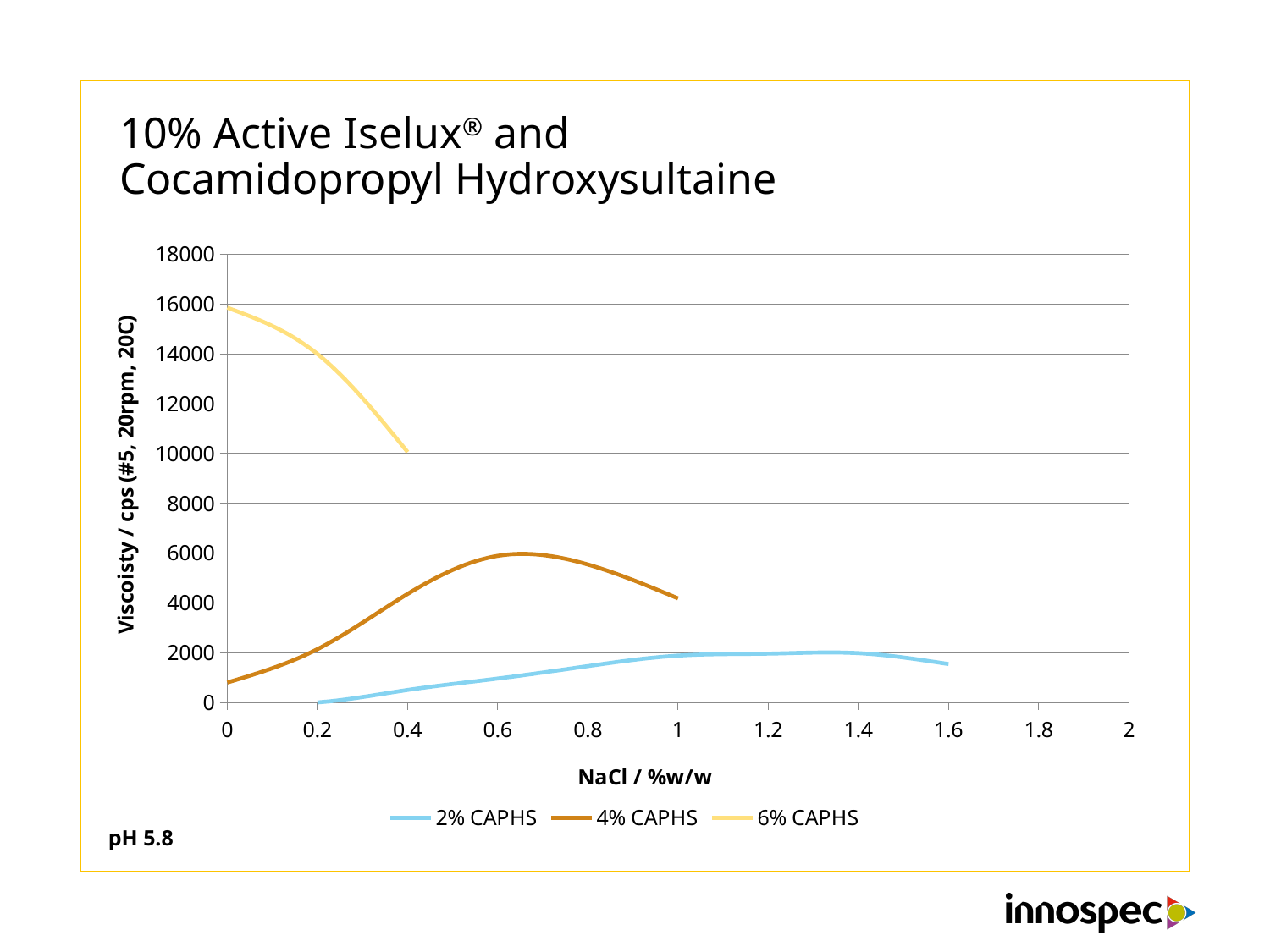
How many series does the legend list? 3 Which series reaches the highest viscosity on the chart? 6% CAPHS Is the peak viscosity of the 4% CAPHS series greater or less than 4000? greater Is the viscosity for 6% CAPHS at 0.4 NaCl greater or less than 12000? less Is the viscosity for 2% CAPHS at 1.6 NaCl greater or less than 4000? less What are the three series listed in the legend? 2% CAPHS, 4% CAPHS, 6% CAPHS What is the label of the x axis? NaCl / %w/w Which series extends to the highest NaCl concentration on the x axis? 2% CAPHS At 0.4 NaCl, which series has the higher viscosity, 6% CAPHS or 4% CAPHS? 6% CAPHS What kind of chart is shown on the slide? line chart Does the viscosity of the 6% CAPHS series rise or fall as NaCl increases? fall